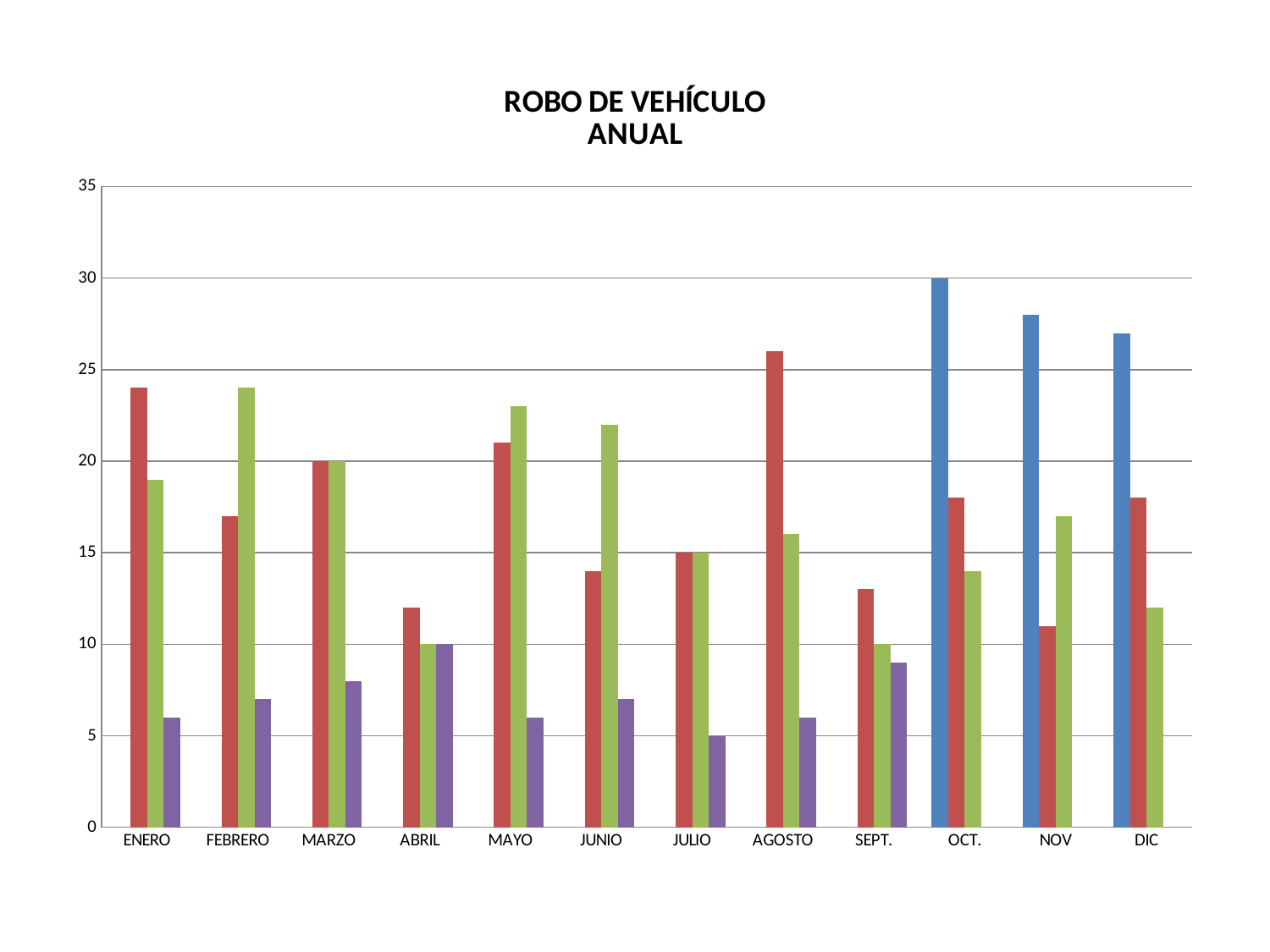
For FEBRERO, which is larger, the red bar or the green bar? the green bar What kind of chart is shown on the slide? bar chart How many months are shown along the x axis? 12 What is the value of the blue bar for OCT.? 30 What is the value of the purple bar for JULIO? 5 Is the value of the red bar for ENERO greater or less than 20? greater What is the value of the red bar for MARZO? 20 Is the value of the red bar for NOV greater or less than 15? less What is the value of the purple bar for ABRIL? 10 What is the title of the chart? ROBO DE VEHÍCULO ANUAL Which month has the tallest blue bar? OCT. Is the value of the red bar for AGOSTO greater or less than 25? greater